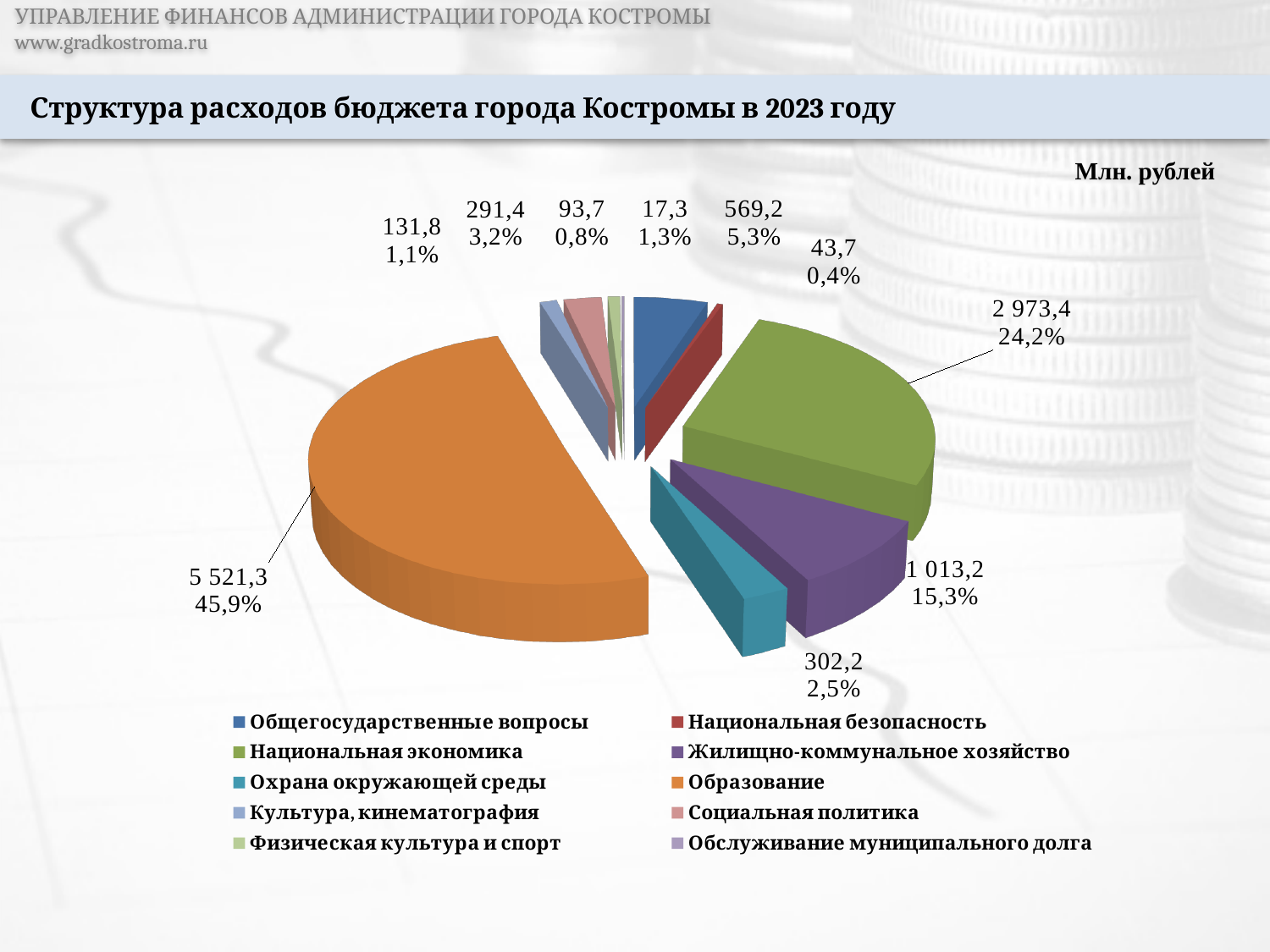
Which category has the largest slice? Образование What is the value for Охрана окружающей среды? 302,2 What kind of chart is shown on the slide? pie chart In what units are the values given, according to the note on the slide? Млн. рублей What is the difference between the values for Образование and Национальная экономика? 2 547,9 What share of the pie does Образование take? 45,9% What share of the pie does Общегосударственные вопросы take? 5,3% How many categories does the legend list? 10 What is the value for Национальная экономика? 2 973,4 Which is larger, Образование or Национальная экономика? Образование What share of the pie does Жилищно-коммунальное хозяйство take? 15,3% What is the value for Образование? 5 521,3